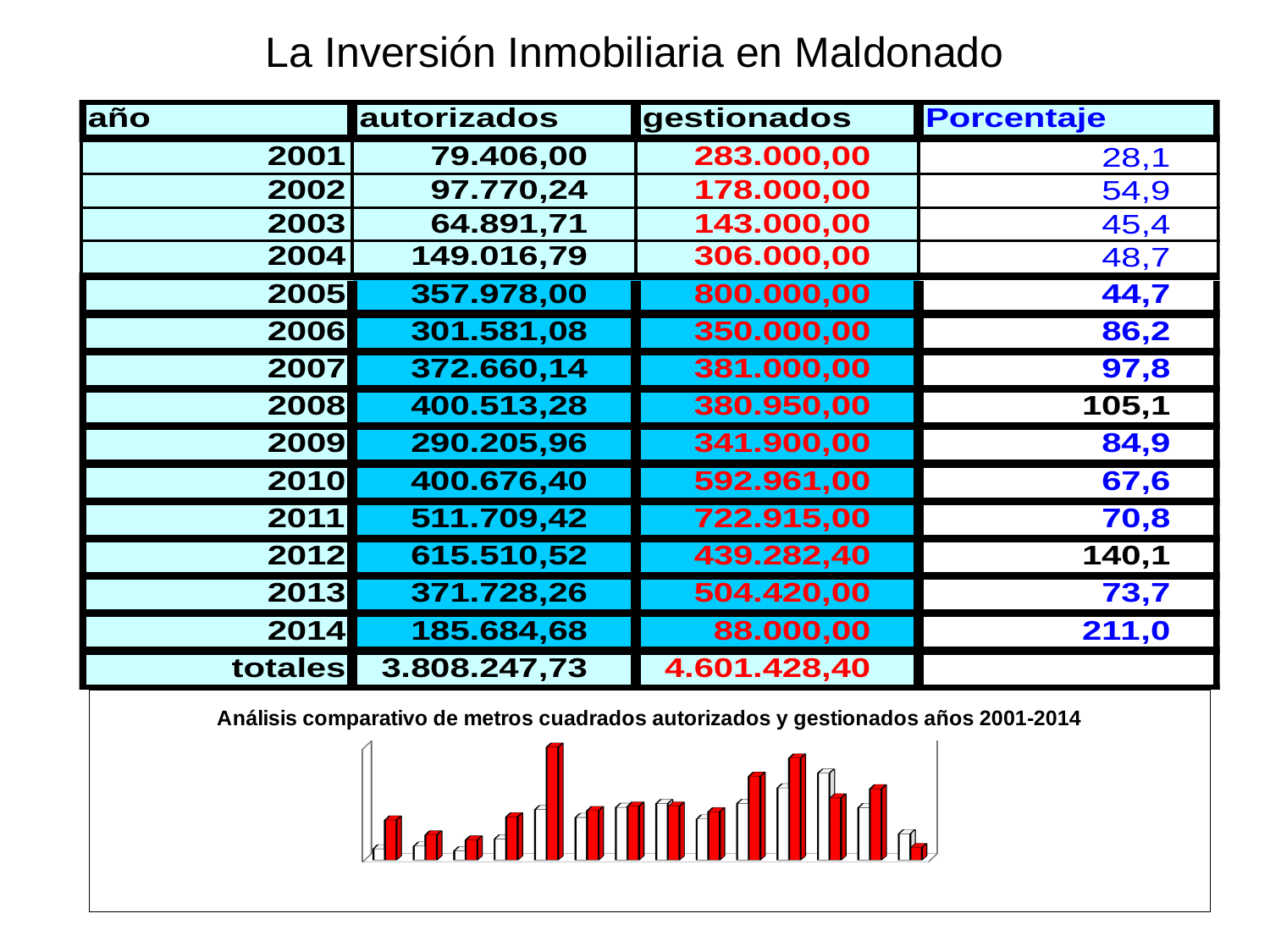
How many bar colours (series) are plotted in the chart at the bottom of the slide? 2 How many groups of bars are plotted in the chart at the bottom of the slide? 14 What kind of chart is shown at the bottom of the slide? bar chart What is the title of the chart at the bottom of the slide? Análisis comparativo de metros cuadrados autorizados y gestionados años 2001-2014 In the chart at the bottom of the slide, which group of bars from the left contains the tallest red bar? the fifth In the chart at the bottom of the slide, in the fifth group of bars from the left, is the red bar or the white bar taller? red In the chart at the bottom of the slide, in the first group of bars on the left, is the red bar or the white bar taller? red In the chart at the bottom of the slide, in the last group of bars on the right, is the red bar or the white bar taller? white